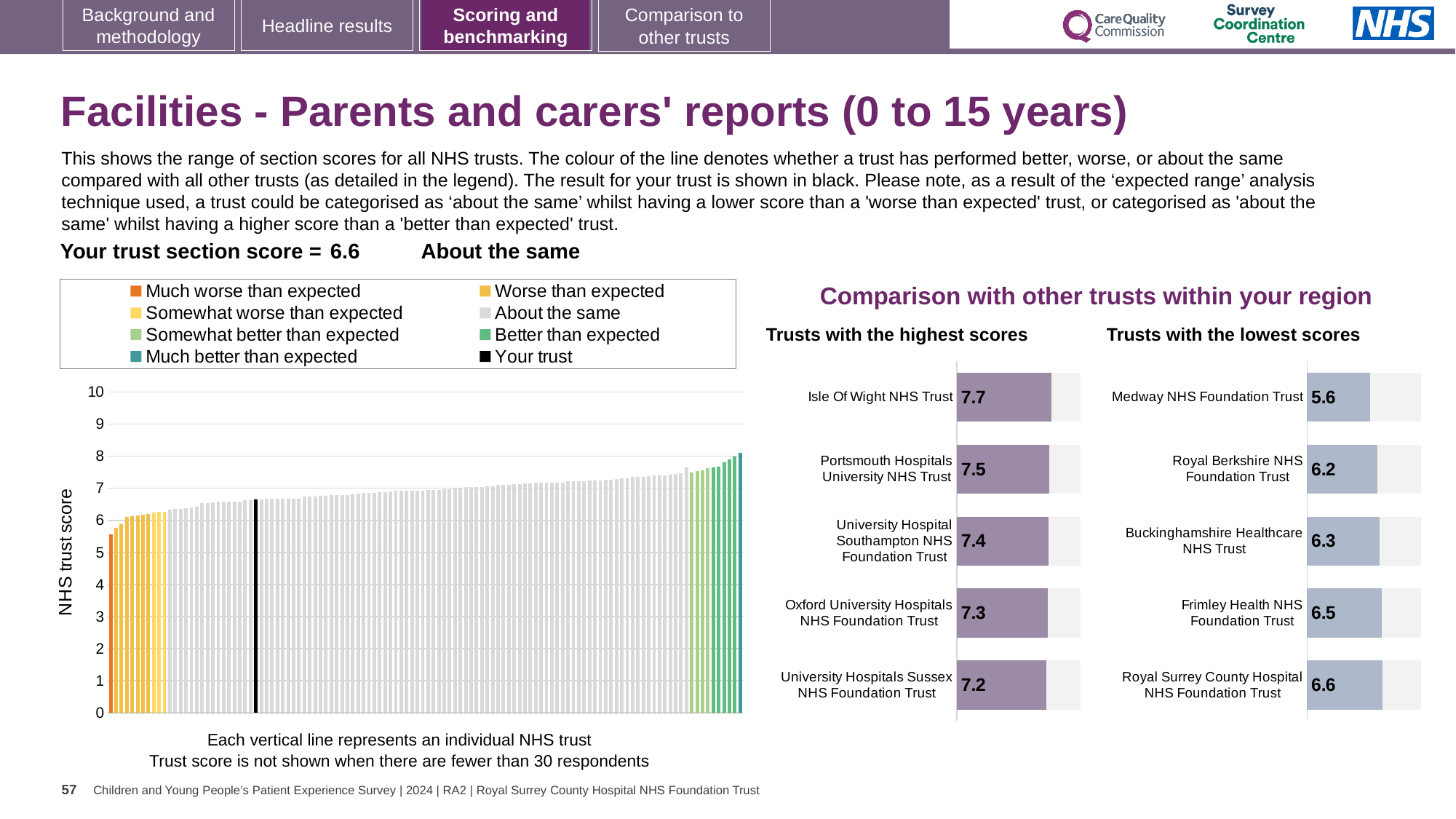
In the 'Trusts with the highest scores' chart, what is the difference between the scores of Isle Of Wight NHS Trust and University Hospitals Sussex NHS Foundation Trust? 0.5 In the 'Trusts with the highest scores' chart, what is the score for Isle Of Wight NHS Trust? 7.7 In the 'Trusts with the lowest scores' chart, which trust has the highest score? Royal Surrey County Hospital NHS Foundation Trust In the 'Trusts with the lowest scores' chart, what is the difference between the scores of Royal Surrey County Hospital NHS Foundation Trust and Medway NHS Foundation Trust? 1.0 What type of chart is the large chart on the left showing NHS trust scores? Bar chart How many entries does the legend of the large chart on the left list? 8 In the 'Trusts with the highest scores' chart, which trust has the lowest score? University Hospitals Sussex NHS Foundation Trust How many trusts are shown in the 'Trusts with the highest scores' chart? 5 What is the section score for your trust shown on the slide? 6.6 In the 'Trusts with the lowest scores' chart, which has the larger score: Royal Berkshire NHS Foundation Trust or Frimley Health NHS Foundation Trust? Frimley Health NHS Foundation Trust In the 'Trusts with the lowest scores' chart, what is the score for Medway NHS Foundation Trust? 5.6 In the large chart on the left, do the NHS trust scores rise or fall from left to right? Rise